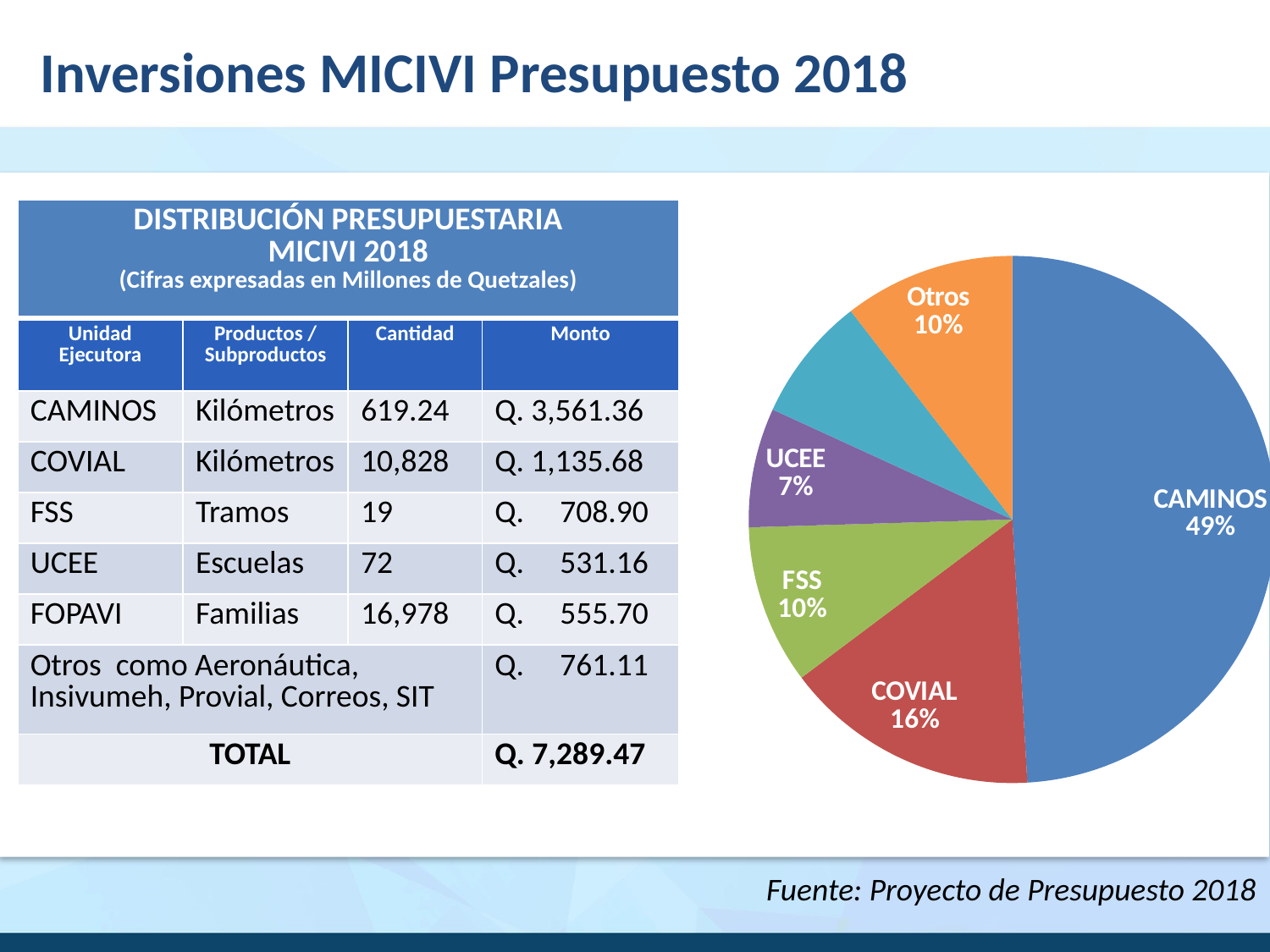
In the pie chart, what percentage is shown for UCEE? 7% In the pie chart, how many percentage points larger is CAMINOS than COVIAL? 33 In the pie chart, what percentage is shown for CAMINOS? 49% In the pie chart, what percentage is shown for FSS? 10% Among the labeled slices of the pie chart, which has the smallest percentage? UCEE What colour is the CAMINOS slice in the pie chart? blue What kind of chart is shown on the right side of the slide? pie chart Which slice of the pie chart has the largest share? CAMINOS How many slices does the pie chart have? 6 In the pie chart, what percentage is shown for COVIAL? 16% In the pie chart, what percentage is shown for Otros? 10% In the pie chart, which is larger, the share for FSS or the share for UCEE? FSS